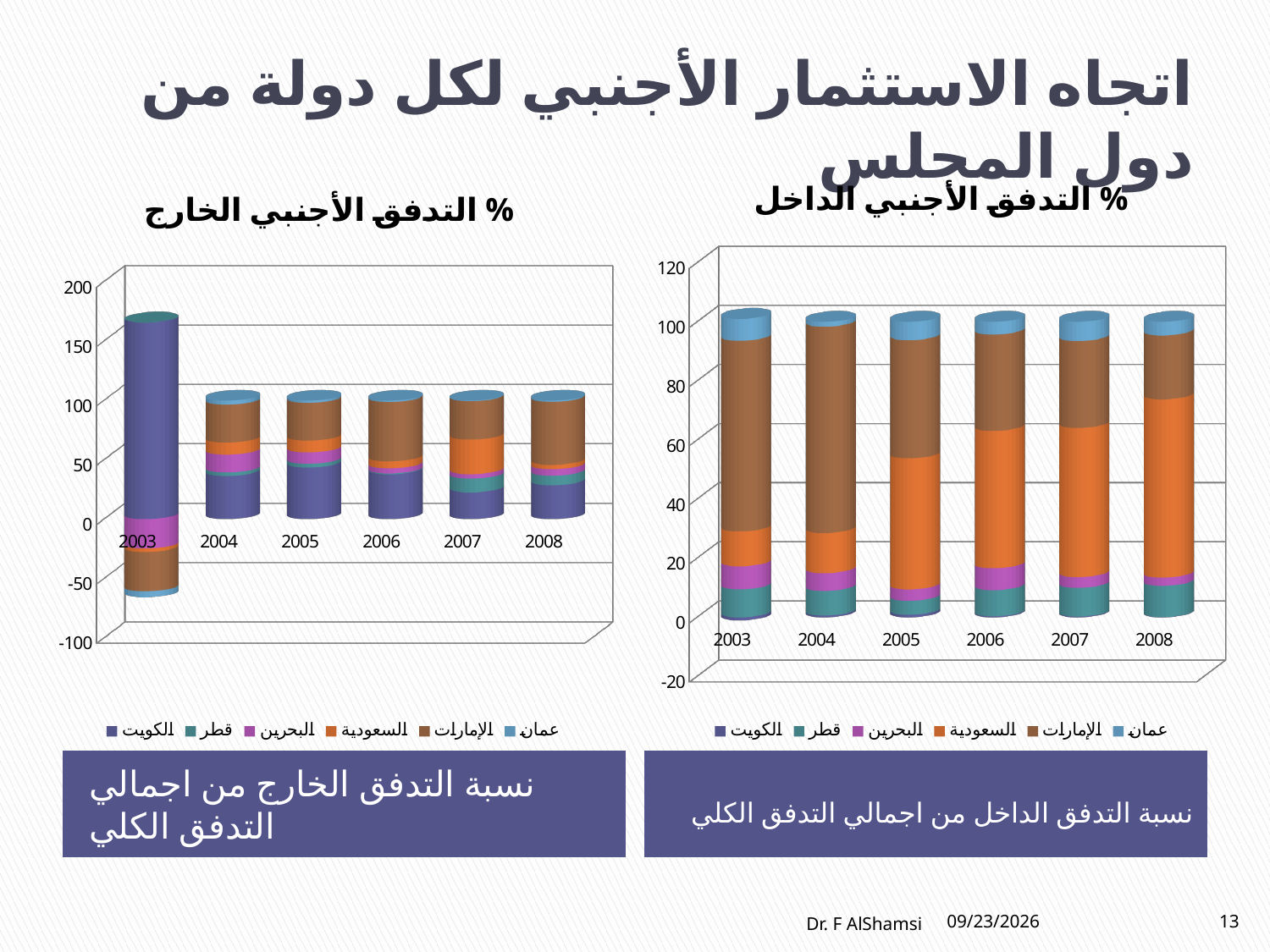
What kind of chart is the chart titled % التدفق الأجنبي الداخل? stacked bar chart In the chart titled % التدفق الأجنبي الداخل, is the total of the 2003 bar greater or less than 80? greater In the chart titled % التدفق الأجنبي الداخل, which series is shown in orange? السعودية In the chart titled % التدفق الأجنبي الداخل, how many years are shown on the x axis? 6 In the chart titled % التدفق الأجنبي الخارج, how many series does the legend list? 6 What kind of chart is the chart titled % التدفق الأجنبي الخارج? stacked bar chart In the chart titled % التدفق الأجنبي الخارج, is the value for الكويت in 2003 greater or less than 150? greater What is the title of the chart on the left side of the slide? % التدفق الأجنبي الخارج In the chart titled % التدفق الأجنبي الخارج, which year has the tallest bar? 2003 In the chart titled % التدفق الأجنبي الخارج, is the total of the 2006 bar greater or less than 50? greater In the chart titled % التدفق الأجنبي الخارج, what is the lowest value shown on the y axis? -100